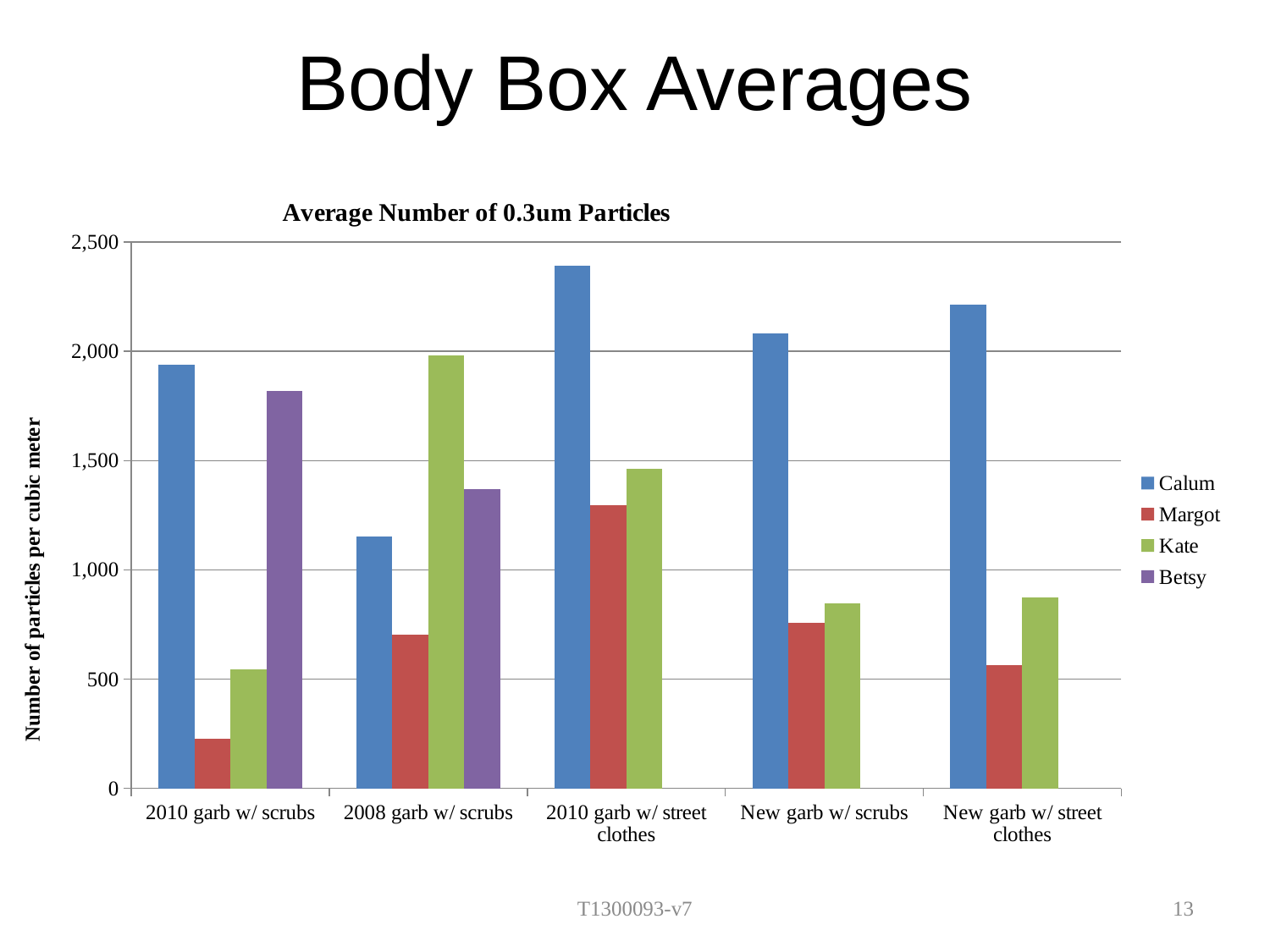
In which category is the Margot bar the lowest? 2010 garb w/ scrubs In New garb w/ scrubs, which series has the highest bar? Calum Is the value for Kate in 2008 garb w/ scrubs greater or less than 1,500? greater Is the value for Margot in 2010 garb w/ scrubs greater or less than 500? less How many categories are shown along the x axis? 5 In which category is the Calum bar the highest? 2010 garb w/ street clothes How many categories include a bar for Betsy? 2 What kind of chart is shown on the slide? bar chart How many series does the legend list? 4 What is the title of the chart? Average Number of 0.3um Particles In 2008 garb w/ scrubs, which is larger: Kate or Calum? Kate Is the value for Calum in 2010 garb w/ street clothes greater or less than 2,000? greater